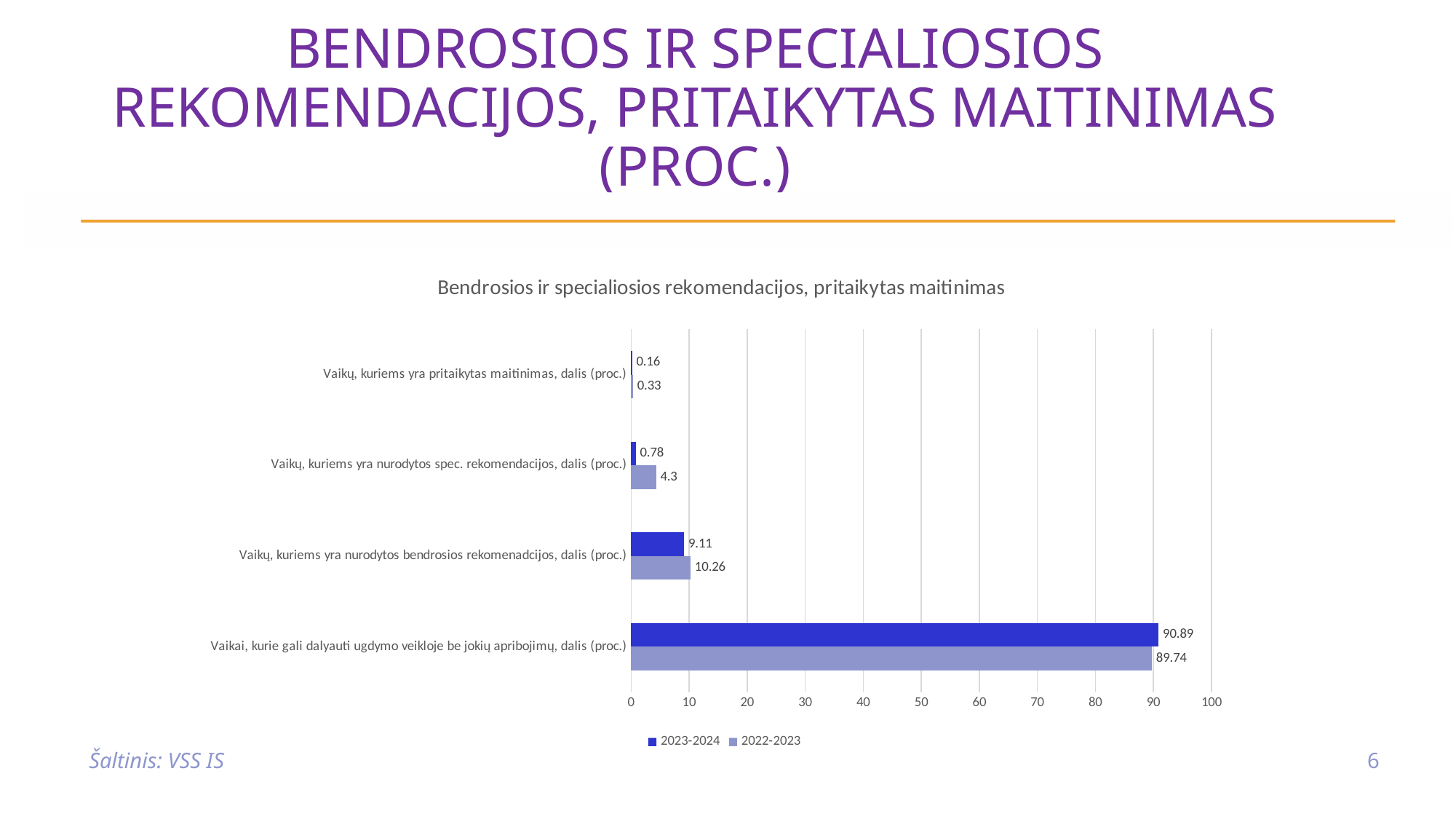
For 'Vaikų, kuriems yra nurodytos spec. rekomendacijos, dalis (proc.)', which series has the larger value, 2023-2024 or 2022-2023? 2022-2023 Which category has the lowest 2022-2023 value? Vaikų, kuriems yra pritaikytas maitinimas, dalis (proc.) What is the 2022-2023 value for 'Vaikų, kuriems yra nurodytos spec. rekomendacijos, dalis (proc.)'? 4.3 What kind of chart is shown on the slide? Bar chart Is the 2022-2023 value for 'Vaikai, kurie gali dalyauti ugdymo veikloje be jokių apribojimų, dalis (proc.)' greater or less than 80? greater What is the 2023-2024 value for 'Vaikų, kuriems yra pritaikytas maitinimas, dalis (proc.)'? 0.16 Which category has the highest 2023-2024 value? Vaikai, kurie gali dalyauti ugdymo veikloje be jokių apribojimų, dalis (proc.) What is the 2023-2024 value for 'Vaikai, kurie gali dalyauti ugdymo veikloje be jokių apribojimų, dalis (proc.)'? 90.89 How many series does the legend list? 2 What is the 2022-2023 value for 'Vaikų, kuriems yra nurodytos bendrosios rekomenadcijos, dalis (proc.)'? 10.26 What is the difference between the 2023-2024 and 2022-2023 values for 'Vaikai, kurie gali dalyauti ugdymo veikloje be jokių apribojimų, dalis (proc.)'? 1.15 How many categories are shown on the chart? 4